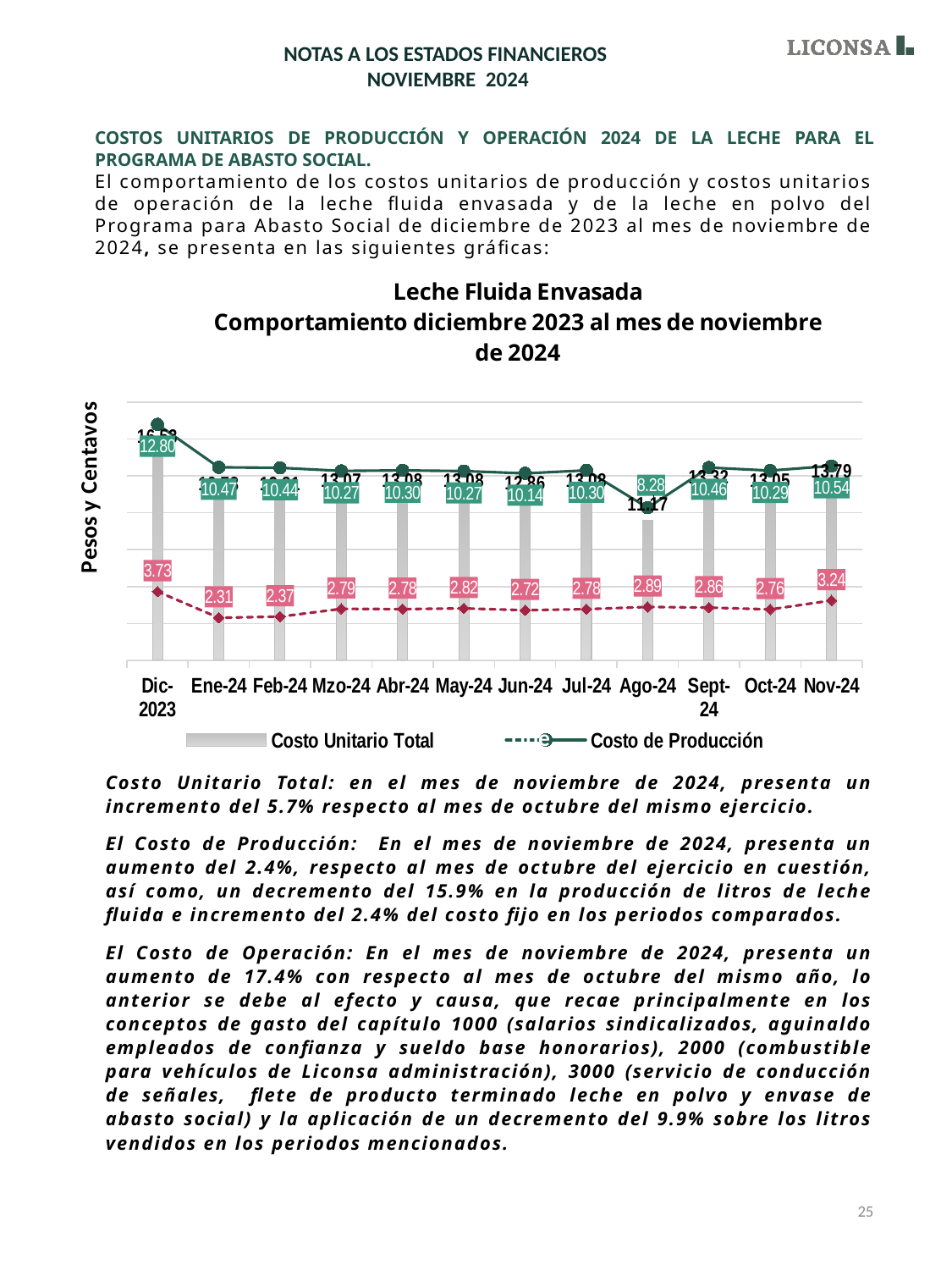
What is the Costo Unitario Total value for Ago-24? 11.17 Which month has a higher Costo Unitario Total, Sept-24 or Oct-24? Sept-24 In which month is the Costo de Producción highest? Dic-2023 What is the difference between the Costo de Producción in Nov-24 and Oct-24? 0.25 What is the Costo Unitario Total value for Nov-24? 13.79 What is the Costo de Producción value for Nov-24? 10.54 What is the Costo de Producción value for Ago-24? 8.28 How many months are shown on the x axis of the chart? 12 How many series does the legend list? 2 In which month is the Costo Unitario Total bar lowest? Ago-24 What is the difference between the Costo Unitario Total in Nov-24 and Oct-24? 0.74 In which month is the Costo de Producción lowest? Ago-24